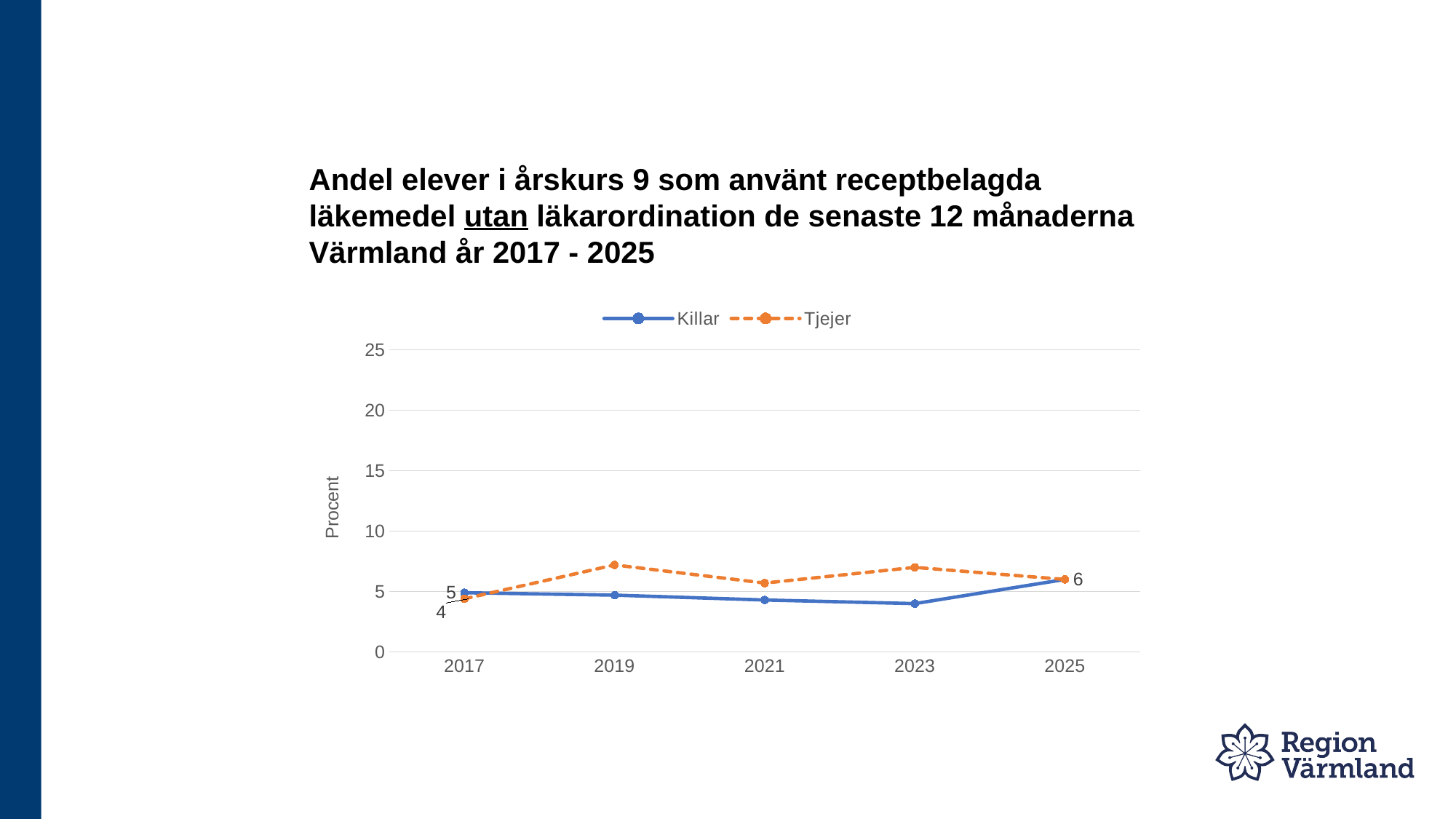
What are the two series named in the legend? Killar and Tjejer What is the difference between Killar and Tjejer in 2017? 1 What is the value for Tjejer in 2017? 4 How many series does the legend list? 2 Is the value for Tjejer in 2019 greater or less than 10? less What is the label on the y axis? Procent How many years are shown on the x axis? 5 What is the value for Killar in 2017? 5 Which series has the higher value in 2017, Killar or Tjejer? Killar Which series has the higher value in 2019, Killar or Tjejer? Tjejer In which year does the Killar series reach its highest value? 2025 What kind of chart is shown on the slide? line chart